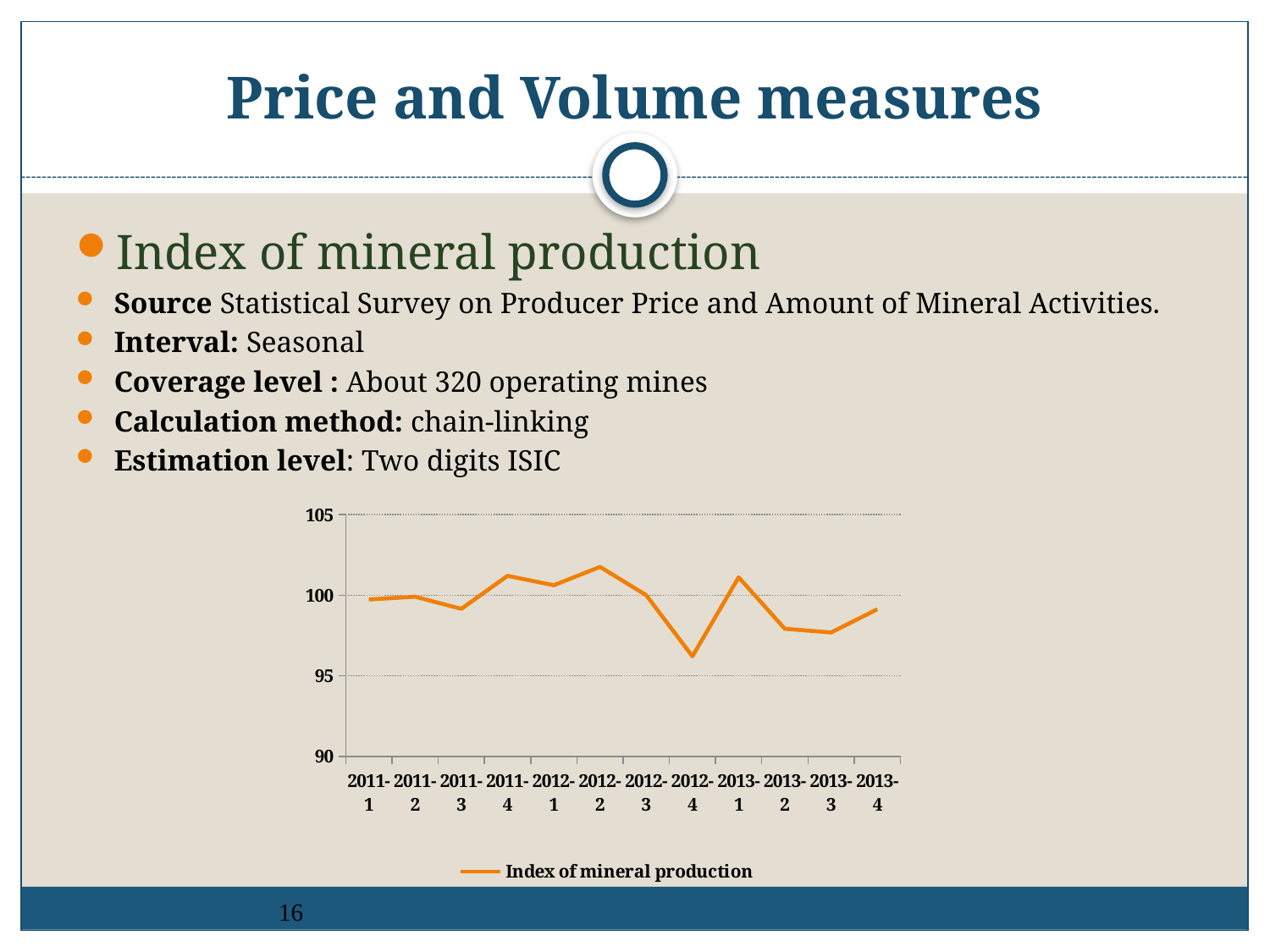
Does the Index of mineral production rise or fall from 2012-2 to 2012-4? fall Is the value for 2012-4 greater or less than 100? less How many series does the chart's legend list? 1 Is the value for 2012-4 greater or less than 95? greater How many data points are plotted along the x axis of the chart? 12 Is the value for 2013-3 greater or less than 100? less Which period has the highest value of the Index of mineral production? 2012-2 Which is larger, the value for 2013-1 or the value for 2012-4? 2013-1 Which period has the lowest value of the Index of mineral production? 2012-4 What is the name of the series shown in the chart's legend? Index of mineral production What kind of chart is shown on the slide? line chart